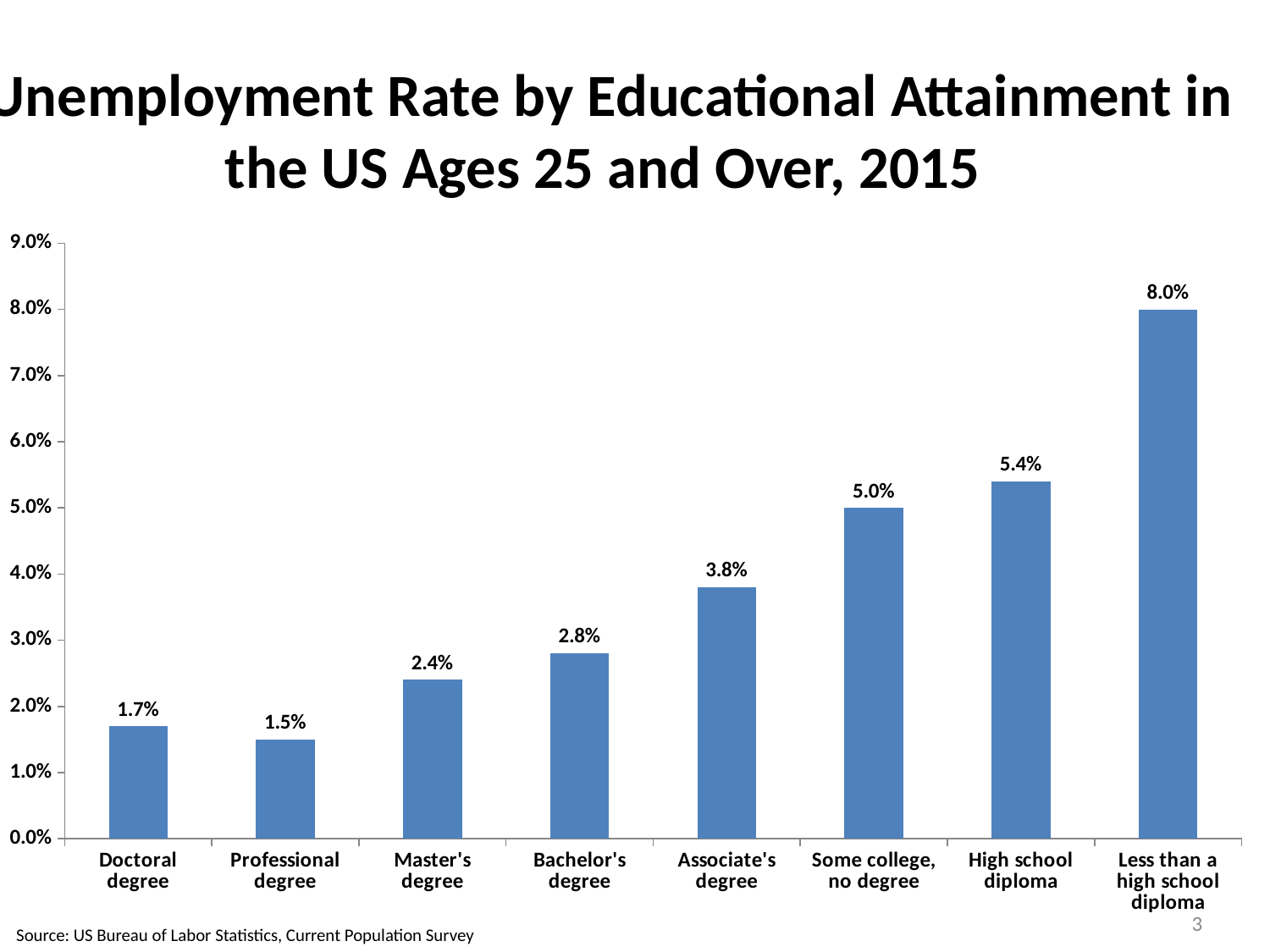
Which has a higher unemployment rate, an Associate's degree or a Bachelor's degree? Associate's degree What is the unemployment rate for people with a Bachelor's degree? 2.8% What is the difference in unemployment rate between a Doctoral degree and a Professional degree? 0.2% Which educational attainment category has the highest unemployment rate? Less than a high school diploma Which educational attainment category has the lowest unemployment rate? Professional degree What is the unemployment rate for people with less than a high school diploma? 8.0% How many educational attainment categories are shown in the chart? 8 Is the unemployment rate for a high school diploma greater or less than 5.0%? greater What is the source cited for the chart data? US Bureau of Labor Statistics, Current Population Survey What is the unemployment rate for people with some college, no degree? 5.0% What is the difference in unemployment rate between a high school diploma and a Master's degree? 3.0% What type of chart is shown on the slide? Bar chart